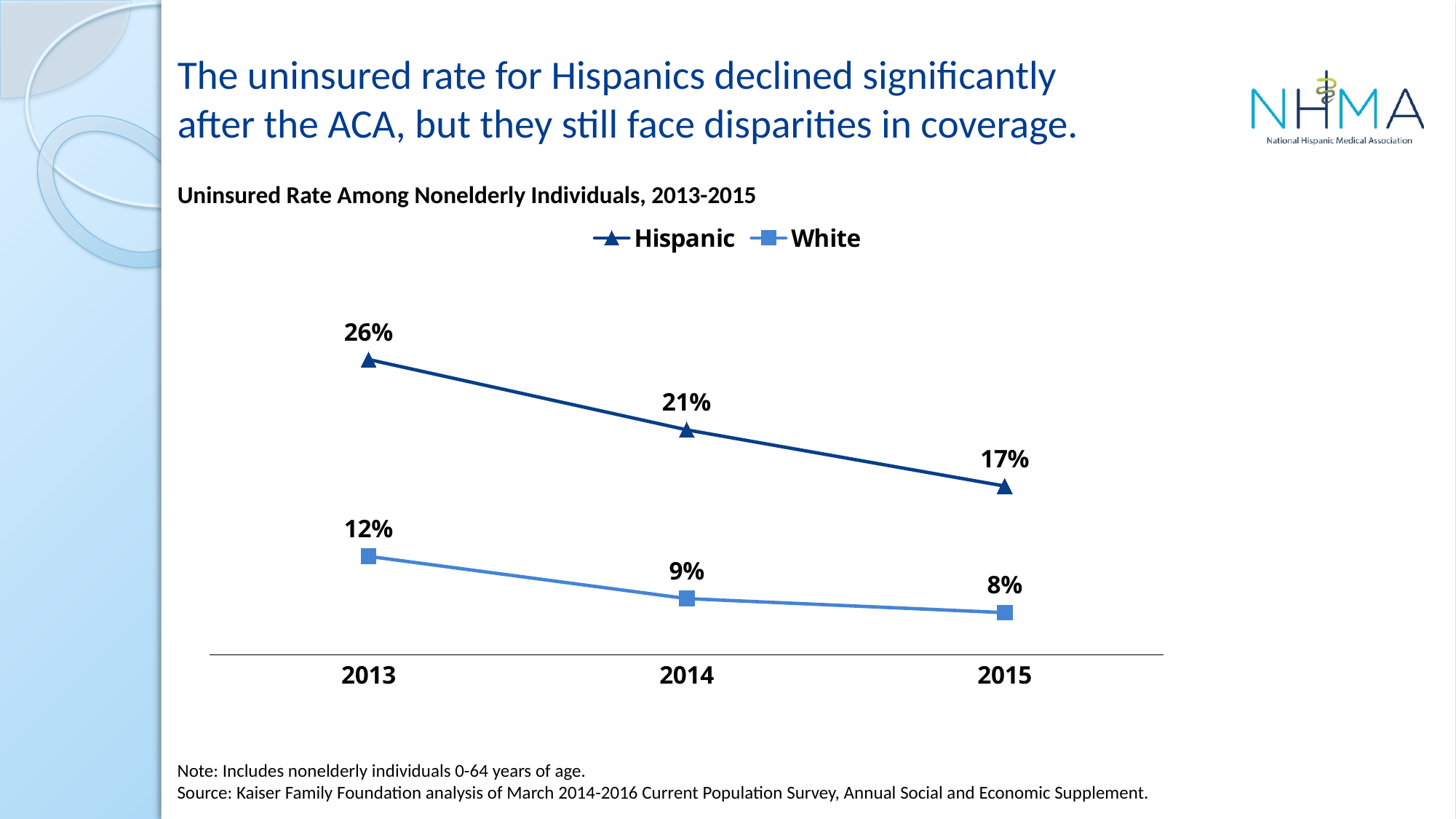
In which year was the White uninsured rate lowest? 2015 How many series does the legend list? 2 In which year was the Hispanic uninsured rate highest? 2013 Does the White uninsured rate rise or fall from 2013 to 2015? Fall How many years are shown on the x axis? 3 What was the uninsured rate for Hispanics in 2014? 21% What was the uninsured rate for White individuals in 2015? 8% Which group had the higher uninsured rate in 2014, Hispanic or White? Hispanic What kind of chart is shown on the slide? Line chart By how many percentage points did the Hispanic uninsured rate fall from 2013 to 2015? 9 percentage points What was the uninsured rate for Hispanics in 2013? 26% What is the difference between the Hispanic and White uninsured rates in 2015? 9 percentage points